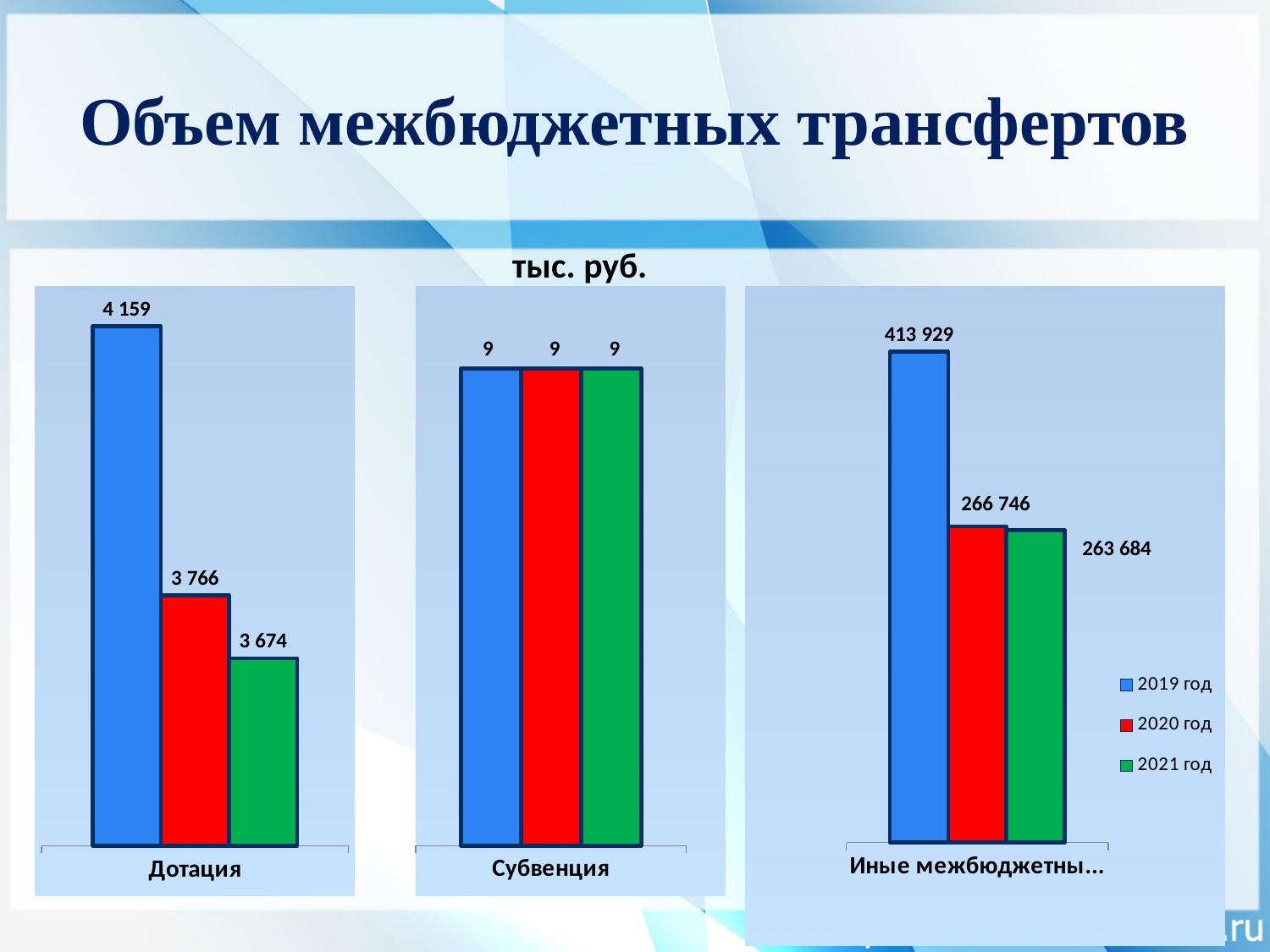
What unit is shown above the charts? тыс. руб. In the Дотация chart, which year has the lowest value? 2021 год In the Дотация chart, what is the value for 2019 год? 4 159 In the Иные межбюджетные chart (right), which year has the highest value? 2019 год In the Дотация chart, what is the difference between the 2019 год and 2020 год values? 393 In the Иные межбюджетные chart (right), what is the value for 2020 год? 266 746 In the Субвенция chart, what is the value for 2021 год? 9 In the Иные межбюджетные chart (right), what is the difference between the 2019 год and 2021 год values? 150 245 What kind of chart is the Дотация chart? bar chart In the Дотация chart, which is larger: the value for 2020 год or 2021 год? 2020 год In the Дотация chart, what is the value for 2021 год? 3 674 How many series does the legend list? 3